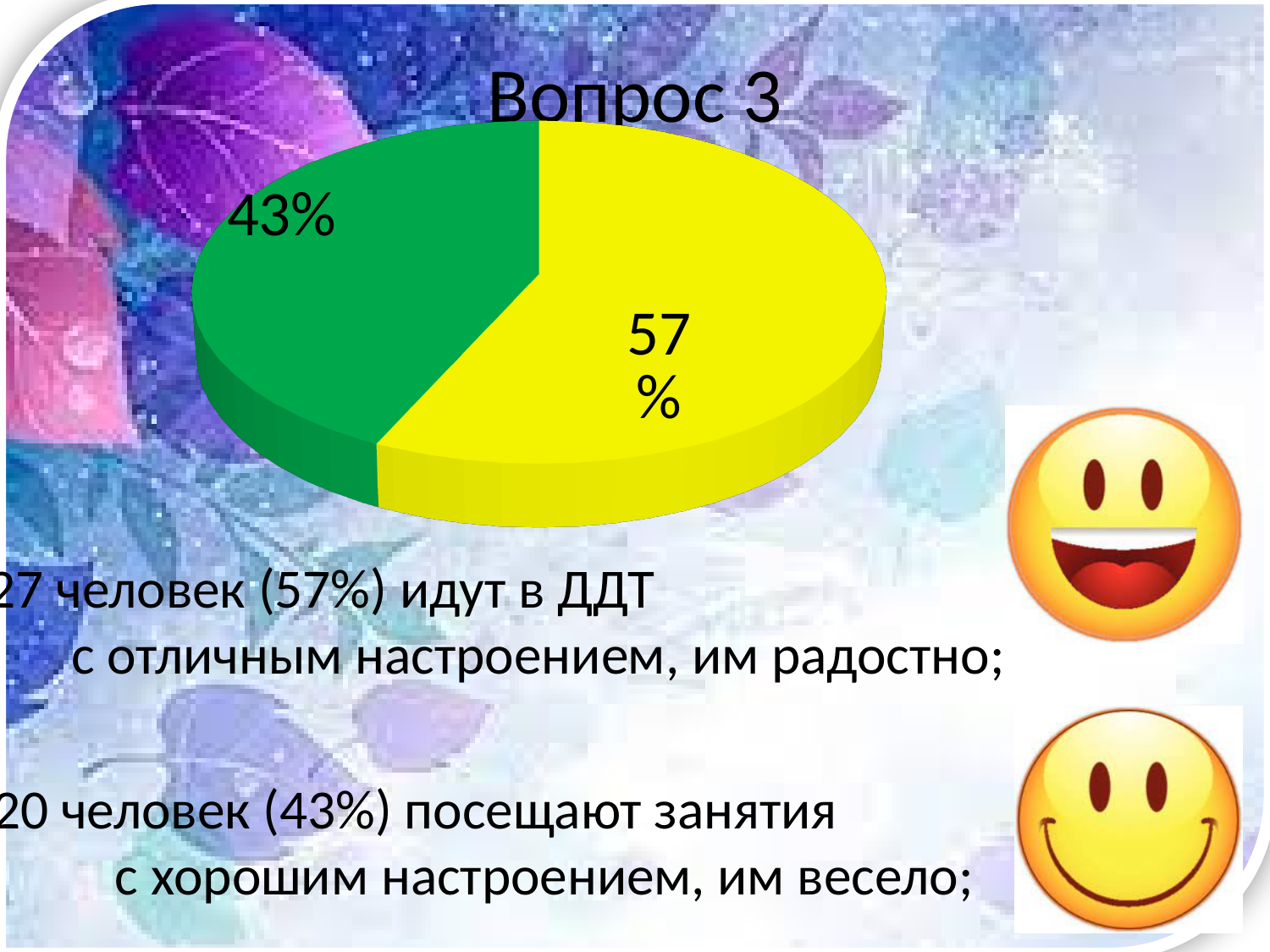
How many slices does the pie chart have? 2 Is the value of the green slice greater or less than 50%? less Which is larger, the green slice or the yellow slice? the yellow slice What is the total of the two slice percentages shown on the pie chart? 100% What colour is the slice labelled 57%? yellow Which slice is the largest in the pie chart? the yellow slice (57%) What kind of chart is shown on the slide? pie chart Which slice is the smallest in the pie chart? the green slice (43%) What share of the pie does the green slice represent? 43% What is the title of the chart? Вопрос 3 What share of the pie does the yellow slice represent? 57% What is the difference in percentage points between the yellow slice and the green slice? 14